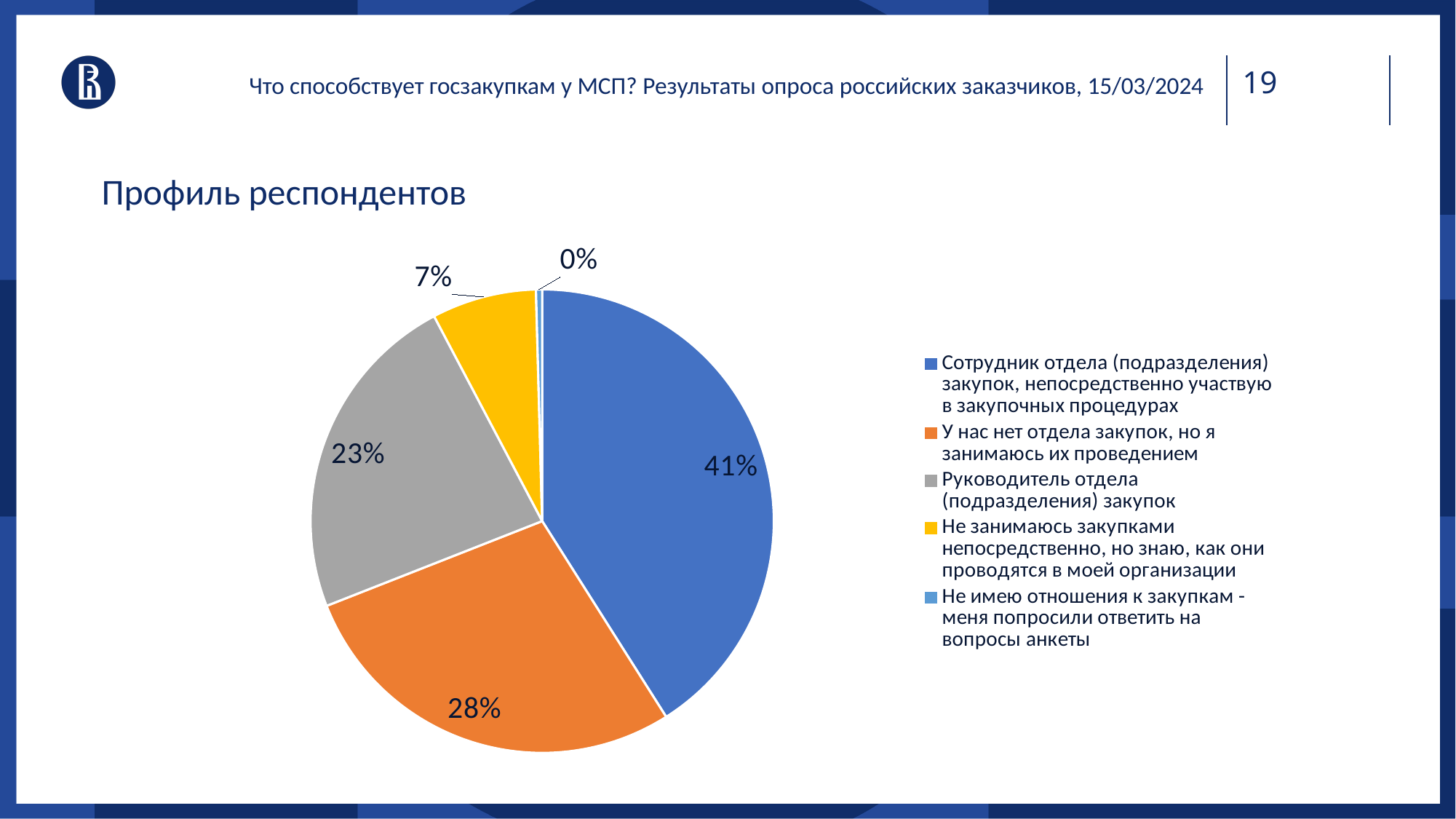
What share of respondents answered 'Не имею отношения к закупкам - меня попросили ответить на вопросы анкеты'? 0% Which respondent category has the largest share? Сотрудник отдела (подразделения) закупок, непосредственно участвую в закупочных процедурах What is the difference in percentage points between the share of 'Сотрудник отдела (подразделения) закупок' and 'Руководитель отдела (подразделения) закупок'? 18 percentage points What share of respondents answered 'Не занимаюсь закупками непосредственно, но знаю, как они проводятся в моей организации'? 7% What share of respondents are 'Сотрудник отдела (подразделения) закупок, непосредственно участвую в закупочных процедурах'? 41% Which is larger: the share of 'У нас нет отдела закупок, но я занимаюсь их проведением' or 'Руководитель отдела (подразделения) закупок'? У нас нет отдела закупок, но я занимаюсь их проведением What type of chart is shown on the slide? pie chart Which respondent category has the smallest share? Не имею отношения к закупкам - меня попросили ответить на вопросы анкеты What share of respondents are 'Руководитель отдела (подразделения) закупок'? 23% How many categories does the legend list? 5 What share of respondents answered 'У нас нет отдела закупок, но я занимаюсь их проведением'? 28% What is the title of the chart? Профиль респондентов